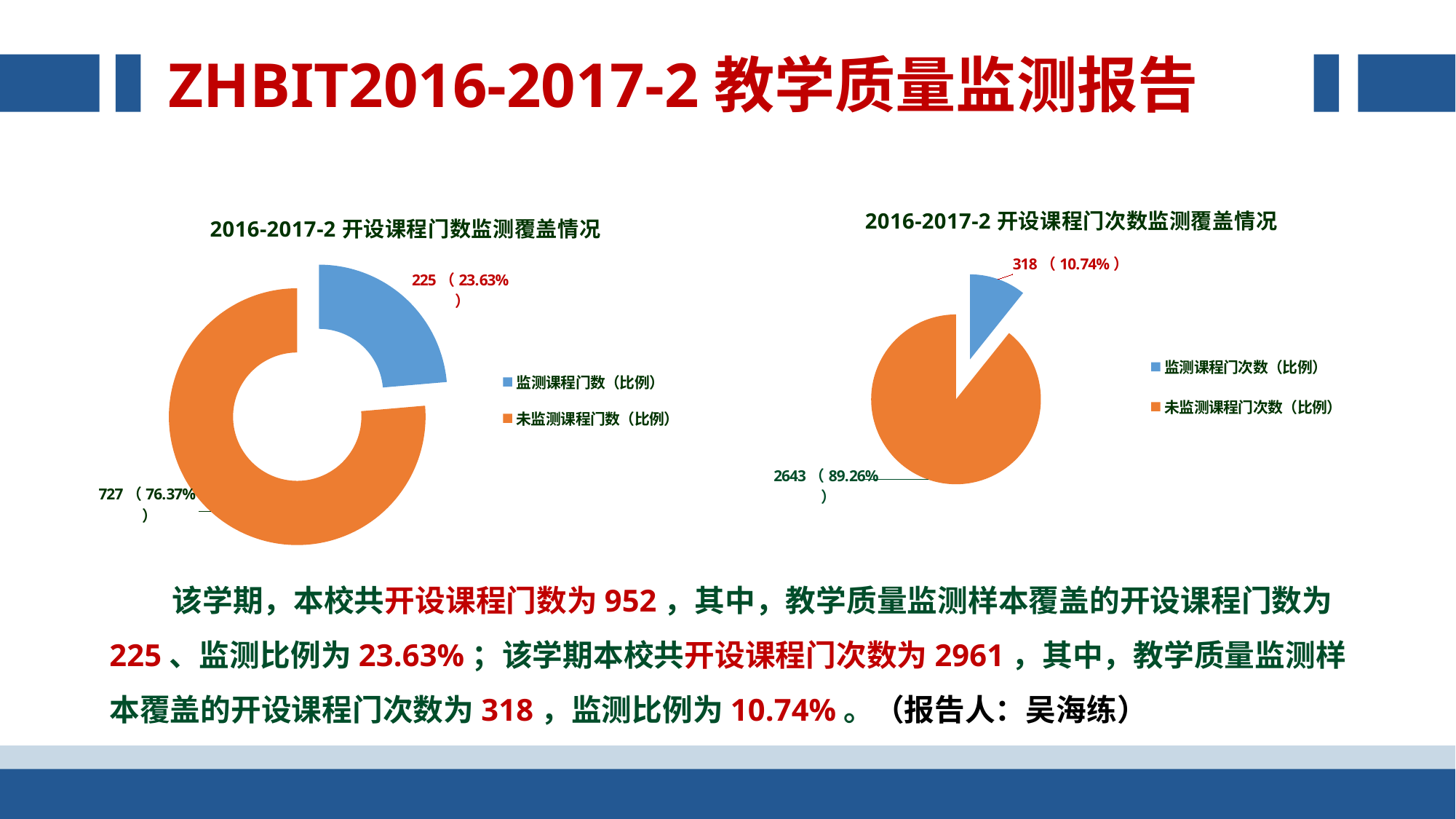
In the left chart titled 2016-2017-2 开设课程门数监测覆盖情况, what share of the pie does 监测课程门数（比例） take? 23.63% In the left chart titled 2016-2017-2 开设课程门数监测覆盖情况, what is the value for 未监测课程门数（比例）? 727（76.37%） In the right chart titled 2016-2017-2 开设课程门次数监测覆盖情况, what share of the pie does 未监测课程门次数（比例） take? 89.26% What kind of chart is the left chart titled 2016-2017-2 开设课程门数监测覆盖情况? Doughnut (pie) chart How many slices does the right chart titled 2016-2017-2 开设课程门次数监测覆盖情况 have? 2 In the right chart titled 2016-2017-2 开设课程门次数监测覆盖情况, which is larger, 监测课程门次数 or 未监测课程门次数? 未监测课程门次数 In the right chart titled 2016-2017-2 开设课程门次数监测覆盖情况, which category has the smallest slice? 监测课程门次数（比例） In the left chart titled 2016-2017-2 开设课程门数监测覆盖情况, which category has the largest slice? 未监测课程门数（比例） In the left chart titled 2016-2017-2 开设课程门数监测覆盖情况, what is the value for 监测课程门数（比例）? 225（23.63%） In the right chart titled 2016-2017-2 开设课程门次数监测覆盖情况, what is the value for 监测课程门次数（比例）? 318（10.74%） In the left chart titled 2016-2017-2 开设课程门数监测覆盖情况, what is the difference between the 未监测课程门数 value and the 监测课程门数 value? 502 In the right chart titled 2016-2017-2 开设课程门次数监测覆盖情况, what is the value for 未监测课程门次数（比例）? 2643（89.26%）